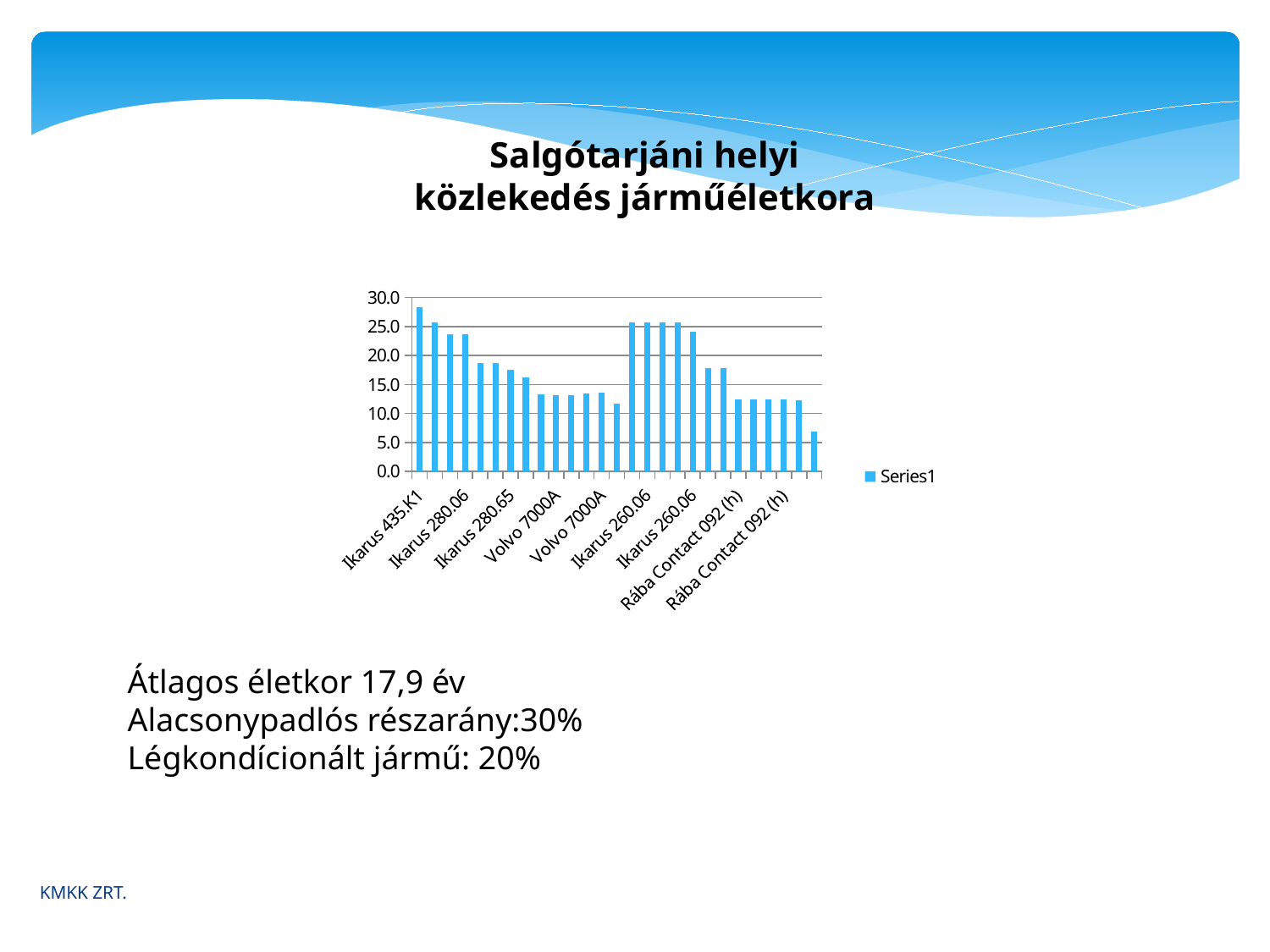
Do the bar values rise or fall across the first eight bars from the left of the chart? fall What kind of chart is shown on the slide? bar chart What is the highest value shown on the chart's vertical axis? 30.0 Is the shortest bar in the chart (the last bar on the right) greater or less than 10.0? less What is the name of the series shown in the chart legend? Series1 Is the first bar on the left of the chart greater or less than 25.0? greater Is the tallest bar in the chart greater or less than 25.0? greater How many series does the chart legend list? 1 Which is taller in the chart: the first bar on the left or the last bar on the right? the first bar on the left What is the title of the chart on the slide? Salgótarjáni helyi közlekedés járműéletkora